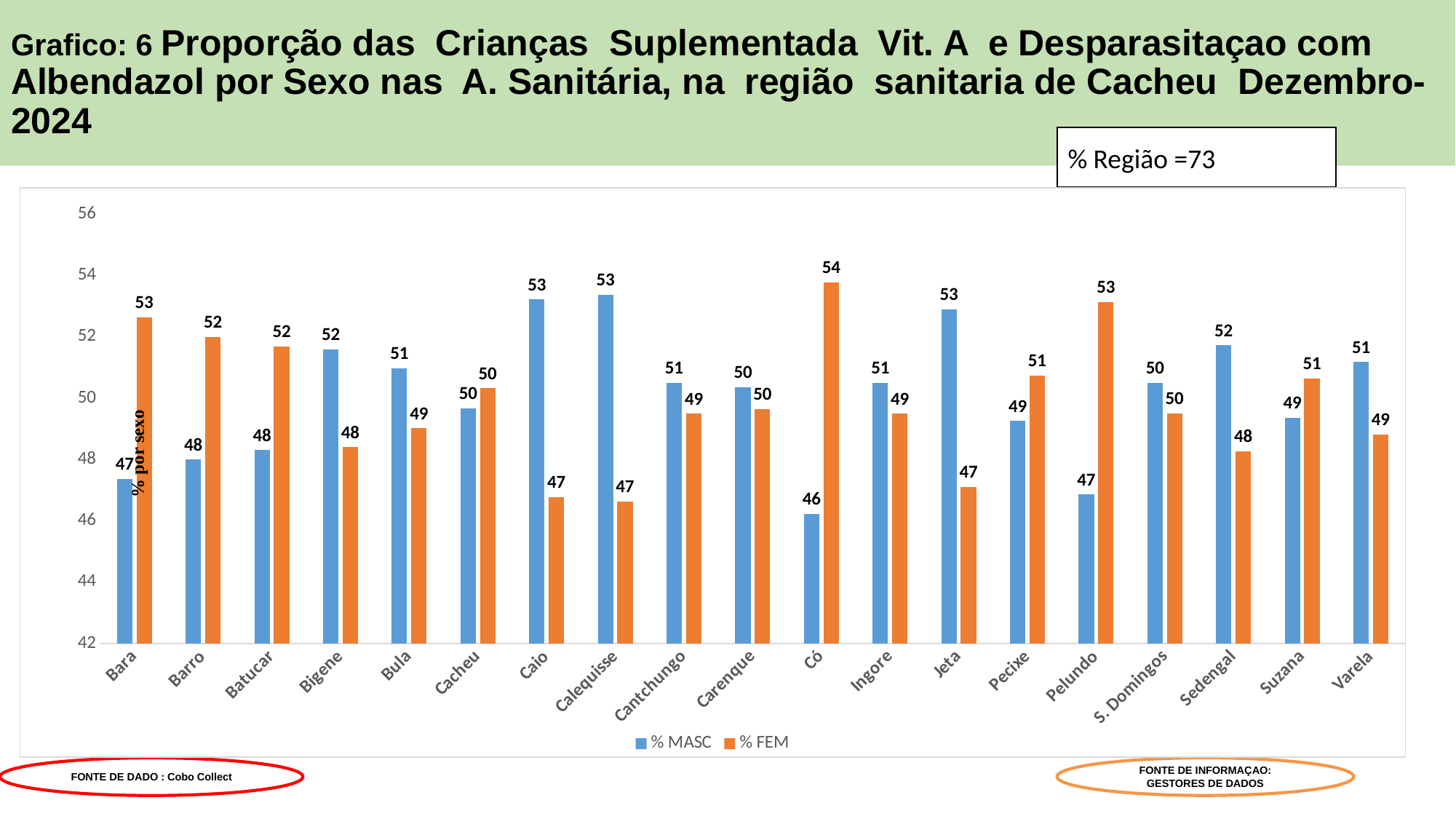
For Bara, which is larger: % MASC or % FEM? % FEM What is the % FEM value for Pelundo? 53 Is the % MASC value for Jeta greater or less than 52? greater How many health areas are shown on the x axis? 19 Which health area has the lowest % MASC value? Có How many series does the legend list? 2 What is the difference between the % MASC and % FEM values for Caio? 6 What kind of chart is shown on the slide? bar chart What are the two series named in the legend? % MASC and % FEM Which health area has the highest % FEM value? Có What is the % MASC value for Bigene? 52 What is the difference between the % FEM and % MASC values for Có? 8